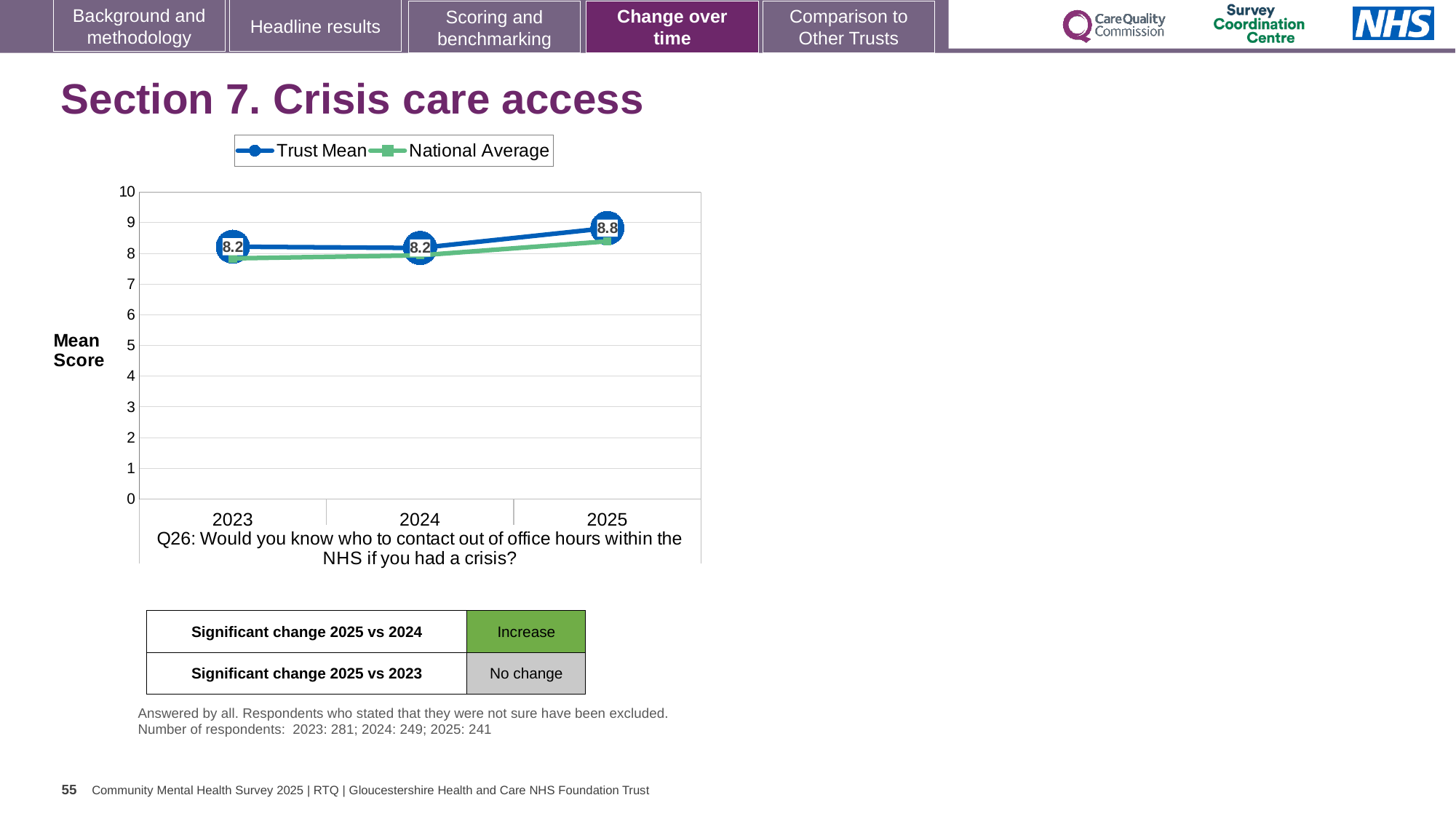
What kind of chart is shown? Line chart How many years are plotted on the x axis? 3 How many series does the legend list? 2 What is the difference between the Trust Mean in 2025 and in 2024? 0.6 In 2025, which is higher: the Trust Mean or the National Average? Trust Mean Is the National Average value for 2023 greater or less than 9? less Does the Trust Mean rise or fall from 2024 to 2025? Rise What is the Trust Mean score for 2023? 8.2 What is the Trust Mean score for 2024? 8.2 What is the Trust Mean score for 2025? 8.8 What is the label on the y axis of the chart? Mean Score In which year is the Trust Mean highest? 2025